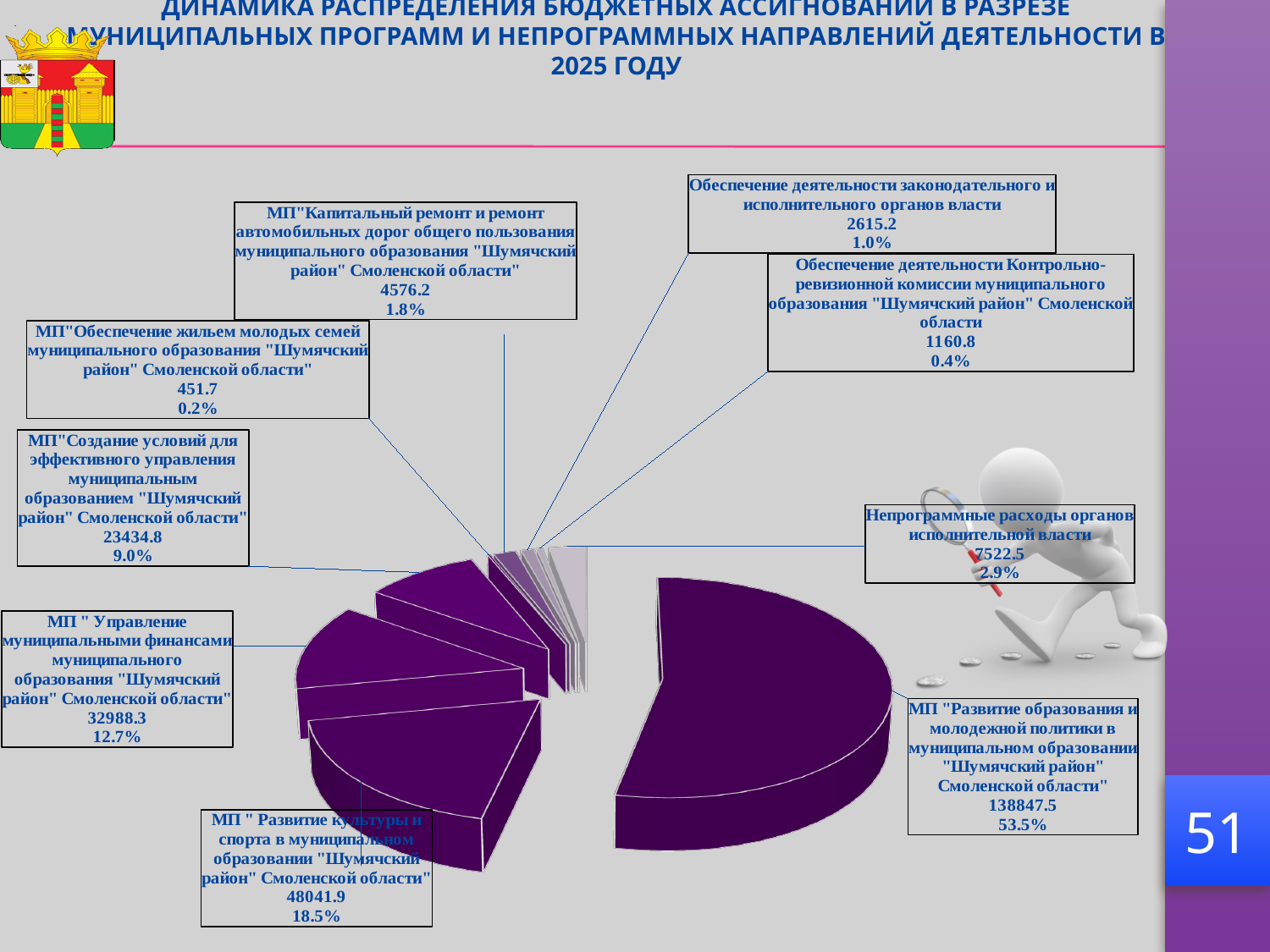
Which is larger: the value for МП "Создание условий для эффективного управления муниципальным образованием" or the value for МП "Капитальный ремонт и ремонт автомобильных дорог"? МП "Создание условий для эффективного управления муниципальным образованием" What is the difference between the values for МП "Развитие культуры и спорта" (48041.9) and МП "Управление муниципальными финансами" (32988.3)? 15053.6 What value is shown for МП "Развитие культуры и спорта в муниципальном образовании "Шумячский район" Смоленской области"? 48041.9 What percentage is shown for Обеспечение деятельности законодательного и исполнительного органов власти? 1.0% What kind of chart is shown on the slide? pie chart Which category has the smallest share of the pie? МП "Обеспечение жильем молодых семей муниципального образования "Шумячский район" Смоленской области" What value is shown for Непрограммные расходы органов исполнительной власти? 7522.5 Which category has the largest share of the pie? МП "Развитие образования и молодежной политики в муниципальном образовании "Шумячский район" Смоленской области" What value is shown for Обеспечение деятельности Контрольно-ревизионной комиссии? 1160.8 How many labeled categories are shown on the pie chart? 9 What percentage is shown for МП "Управление муниципальными финансами"? 12.7% What share of the pie does МП "Развитие образования и молодежной политики" account for? 53.5%